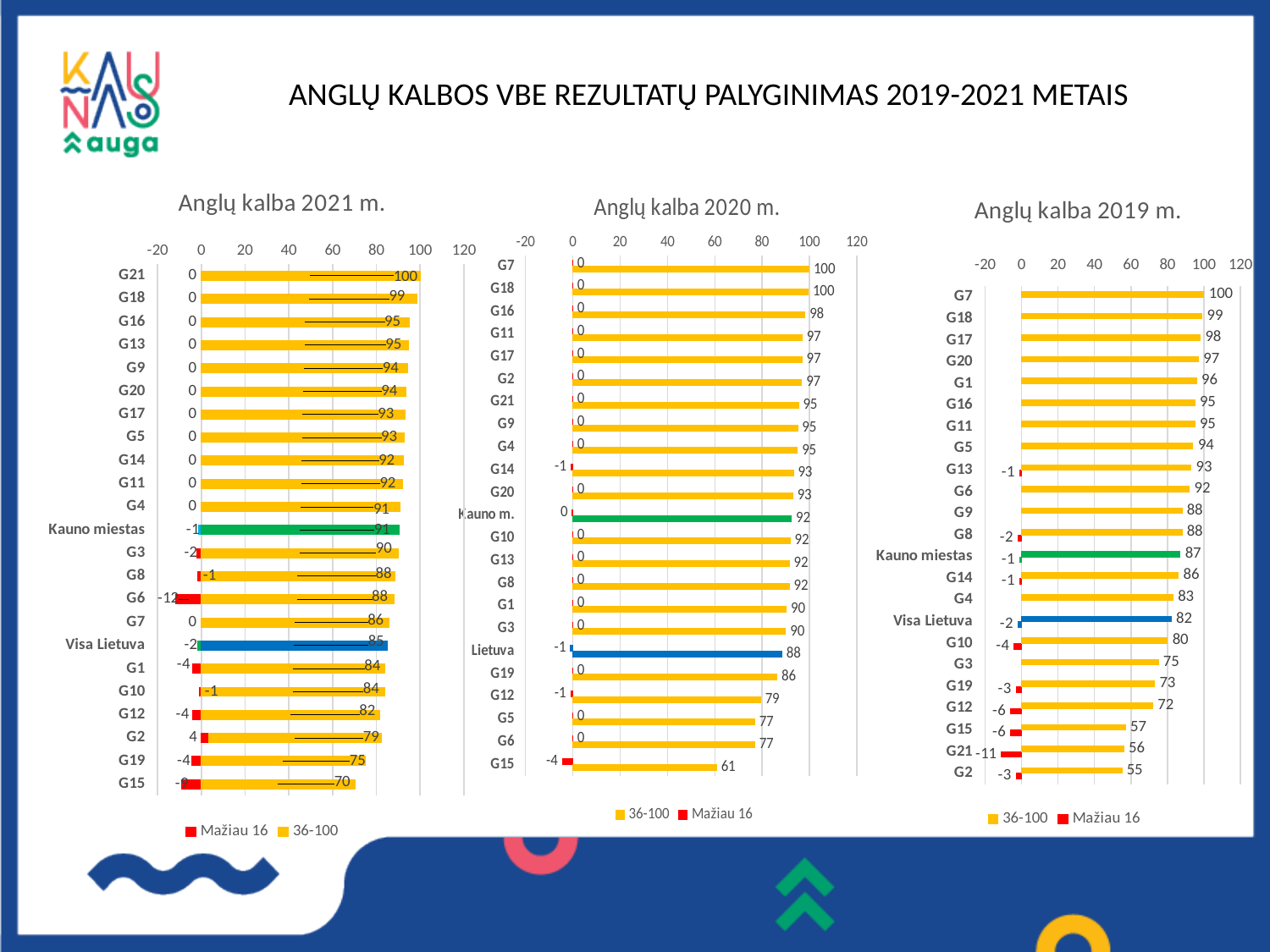
In the 'Anglų kalba 2021 m.' chart, what is the Mažiau 16 value for G6? -12 In the 'Anglų kalba 2019 m.' chart, what is the Mažiau 16 value for G21? -11 In the 'Anglų kalba 2019 m.' chart, what is the 36-100 value for Kauno miestas? 87 In the 'Anglų kalba 2021 m.' chart, what is the 36-100 value for G21? 100 What type of chart is 'Anglų kalba 2021 m.'? Bar chart In the 'Anglų kalba 2020 m.' chart, what is the Mažiau 16 value for G15? -4 In the 'Anglų kalba 2021 m.' chart, which category has the lowest 36-100 value? G15 How many series does the legend of the 'Anglų kalba 2020 m.' chart list? 2 In the 'Anglų kalba 2019 m.' chart, which has a higher 36-100 value, G10 or G3? G10 In the 'Anglų kalba 2020 m.' chart, what is the 36-100 value for Lietuva? 88 In the 'Anglų kalba 2020 m.' chart, what is the difference between the 36-100 values of G7 and G15? 39 In the 'Anglų kalba 2019 m.' chart, which category has the lowest 36-100 value? G2